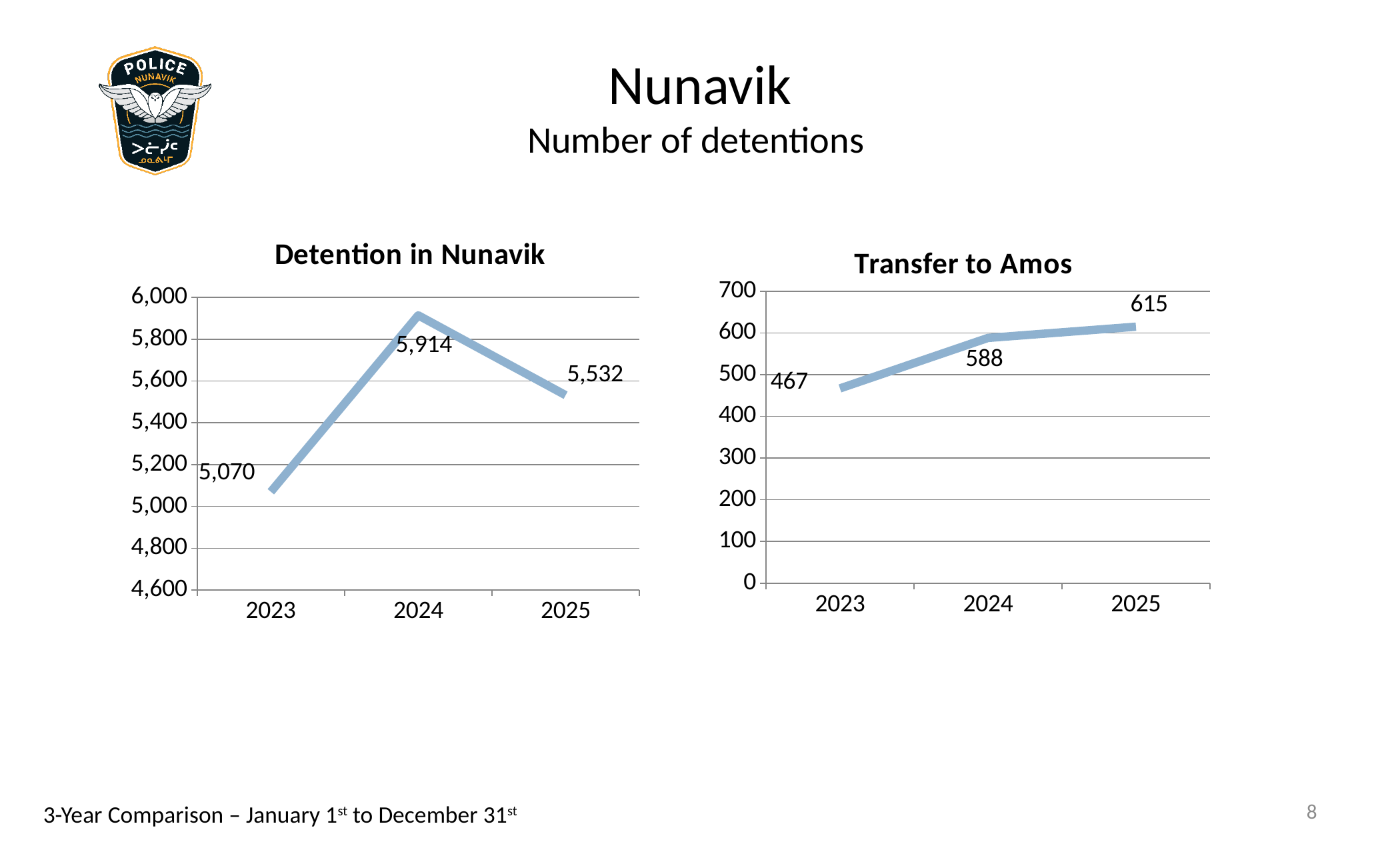
In the 'Detention in Nunavik' chart, what is the value for 2024? 5,914 What kind of chart is the 'Detention in Nunavik' chart? line chart In the 'Detention in Nunavik' chart, which year has the highest value? 2024 In the 'Detention in Nunavik' chart, what is the difference between the 2024 and 2025 values? 382 In the 'Transfer to Amos' chart, what is the difference between the 2024 and 2023 values? 121 In the 'Detention in Nunavik' chart, which is larger, the value for 2023 or the value for 2025? 2025 In the 'Detention in Nunavik' chart, what is the value for 2023? 5,070 How many data points are plotted in the 'Transfer to Amos' chart? 3 In the 'Transfer to Amos' chart, do the values rise or fall from 2023 to 2025? rise In the 'Transfer to Amos' chart, what is the value for 2025? 615 In the 'Transfer to Amos' chart, which year has the lowest value? 2023 In the 'Transfer to Amos' chart, what is the value for 2023? 467